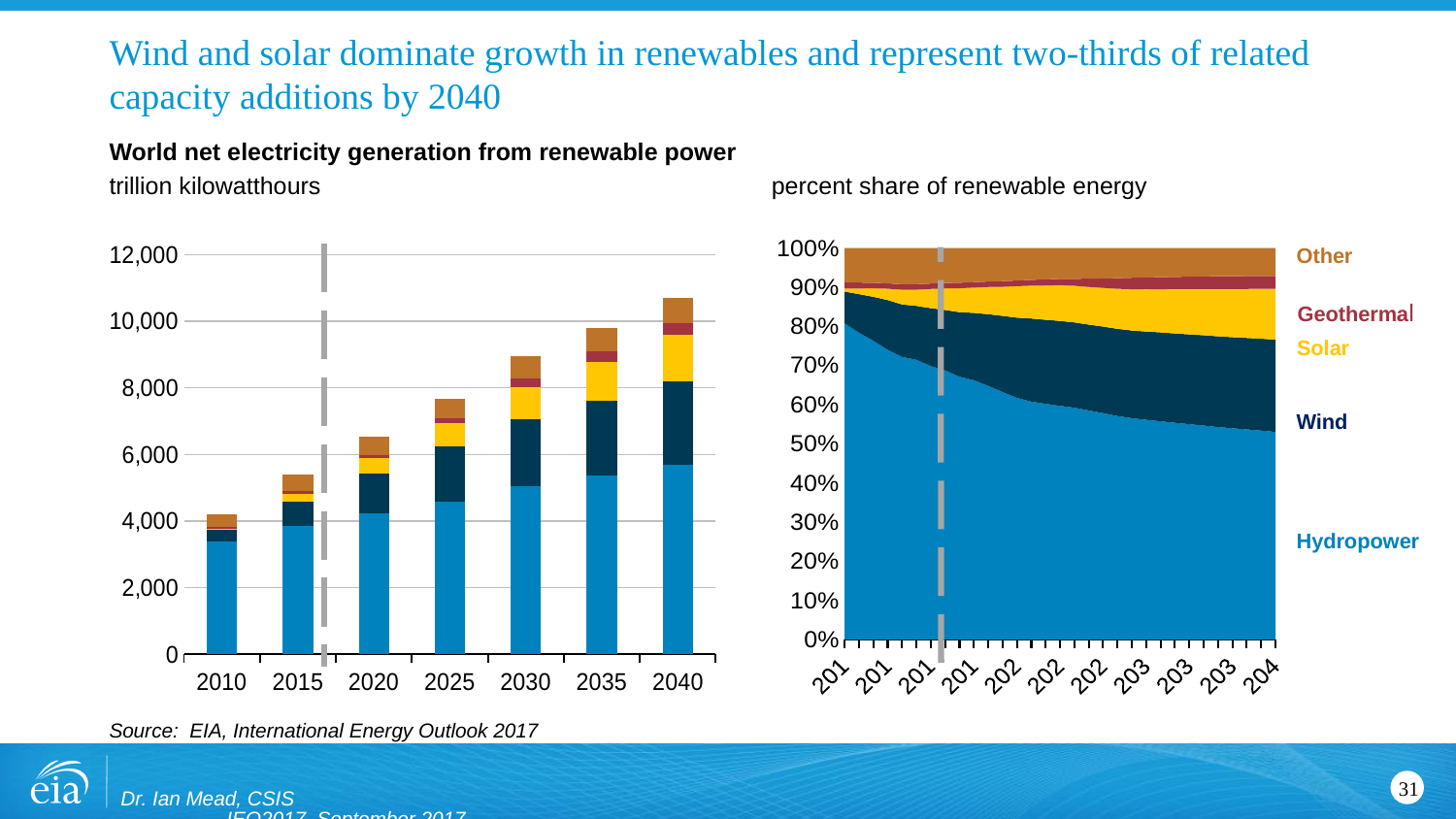
What kind of chart is the left chart (trillion kilowatthours)? bar chart In the left chart (trillion kilowatthours), which year has the highest total renewable generation? 2040 In the right chart (percent share of renewable energy), does the Hydropower share rise or fall over the period shown? fall How many bars (years) are shown in the left chart (trillion kilowatthours)? 7 In the left chart (trillion kilowatthours), which year has the lowest total renewable generation? 2010 In the left chart (trillion kilowatthours), is the total for 2010 greater or less than 6,000? less In the left chart (trillion kilowatthours), is the total for 2040 greater or less than 10,000? greater How many series does the legend of the right chart (percent share of renewable energy) list? 5 What kind of chart is the right chart (percent share of renewable energy)? area chart In the left chart (trillion kilowatthours), do total renewable generation values rise or fall from 2010 to 2040? rise In the left chart (trillion kilowatthours), is the total for 2030 greater or less than 8,000? greater